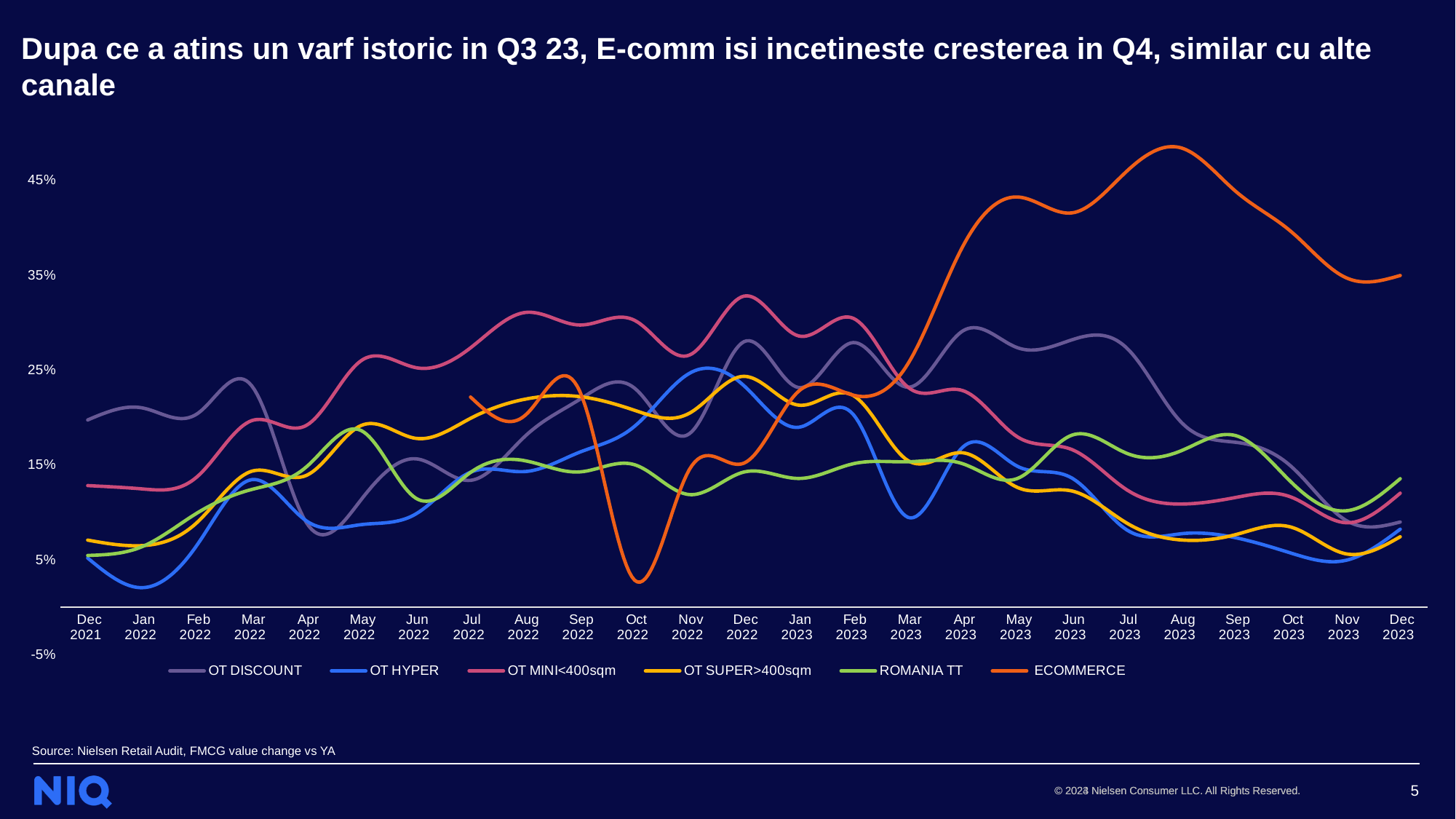
Which series has the lowest value in Jan 2022? OT HYPER Is the value for ECOMMERCE in Aug 2023 greater or less than 45%? greater Which series has the highest value in Aug 2023? ECOMMERCE In Dec 2023, which is larger: the value for ECOMMERCE or the value for OT HYPER? ECOMMERCE Does the ECOMMERCE line rise or fall from Aug 2023 to Nov 2023? fall What colour is the ECOMMERCE line in the legend? orange Is the value for OT MINI<400sqm in Dec 2022 greater or less than 25%? greater How many series does the legend list? 6 How many monthly points are shown along the x axis? 25 Is the value for ECOMMERCE in Oct 2022 greater or less than 5%? less What kind of chart is shown on the slide? line chart